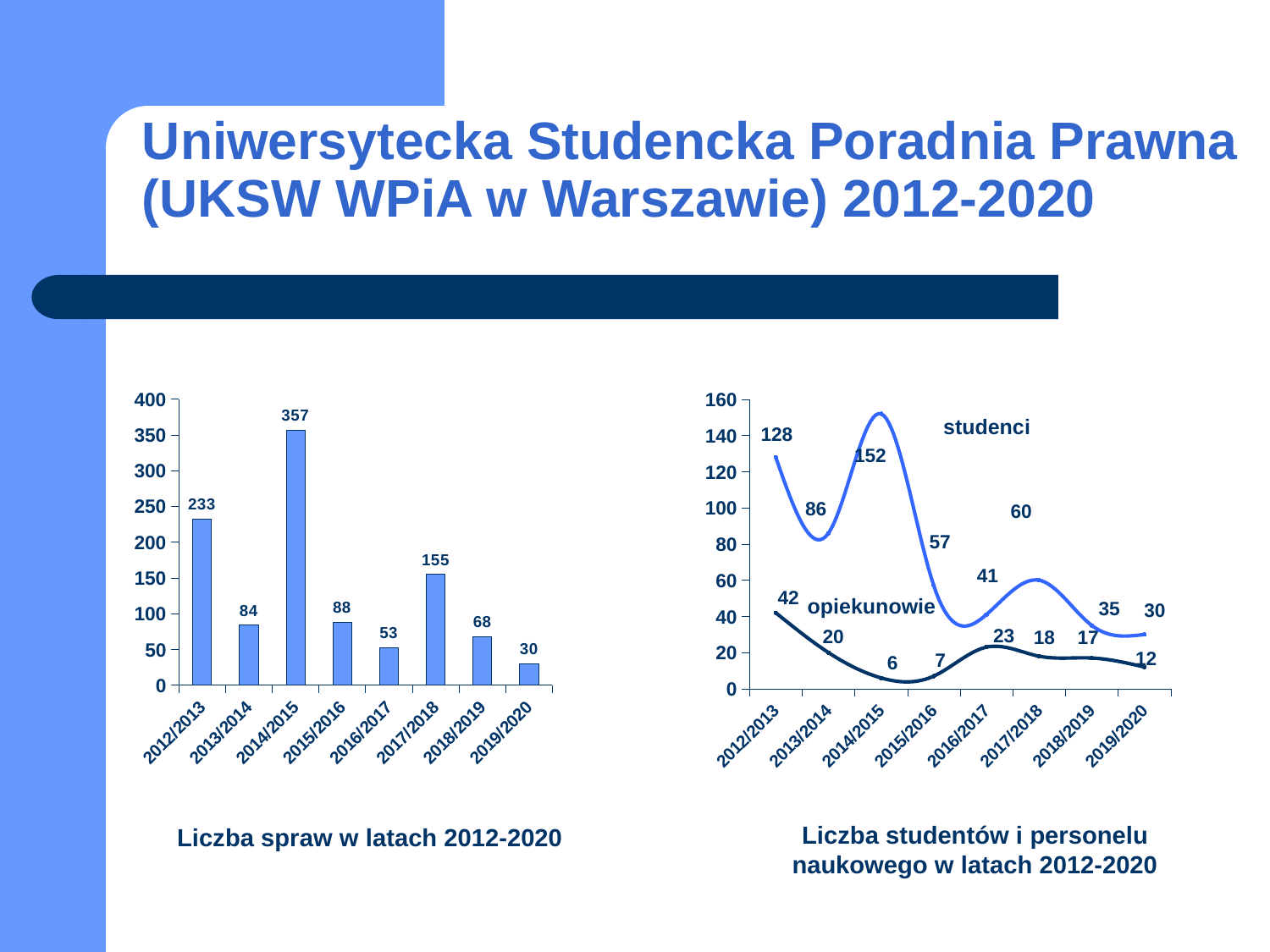
In the left chart (Liczba spraw w latach 2012-2020), what is the value for 2014/2015? 357 In the left chart (Liczba spraw w latach 2012-2020), how many years are shown on the x axis? 8 In the left chart (Liczba spraw w latach 2012-2020), what is the difference between the values for 2012/2013 and 2013/2014? 149 In the right chart (Liczba studentów i personelu naukowego w latach 2012-2020), what is the value for opiekunowie in 2019/2020? 12 In the right chart (Liczba studentów i personelu naukowego w latach 2012-2020), how many series are plotted? 2 In the right chart (Liczba studentów i personelu naukowego w latach 2012-2020), what is the value for studenci in 2014/2015? 152 In the left chart (Liczba spraw w latach 2012-2020), which is larger, the value for 2017/2018 or the value for 2018/2019? 2017/2018 What kind of chart is the right chart (Liczba studentów i personelu naukowego w latach 2012-2020)? line chart In the right chart (Liczba studentów i personelu naukowego w latach 2012-2020), what is the difference between studenci and opiekunowie in 2012/2013? 86 In the right chart (Liczba studentów i personelu naukowego w latach 2012-2020), in which year is the opiekunowie value lowest? 2014/2015 In the left chart (Liczba spraw w latach 2012-2020), which year has the lowest value? 2019/2020 What kind of chart is the left chart (Liczba spraw w latach 2012-2020)? bar chart